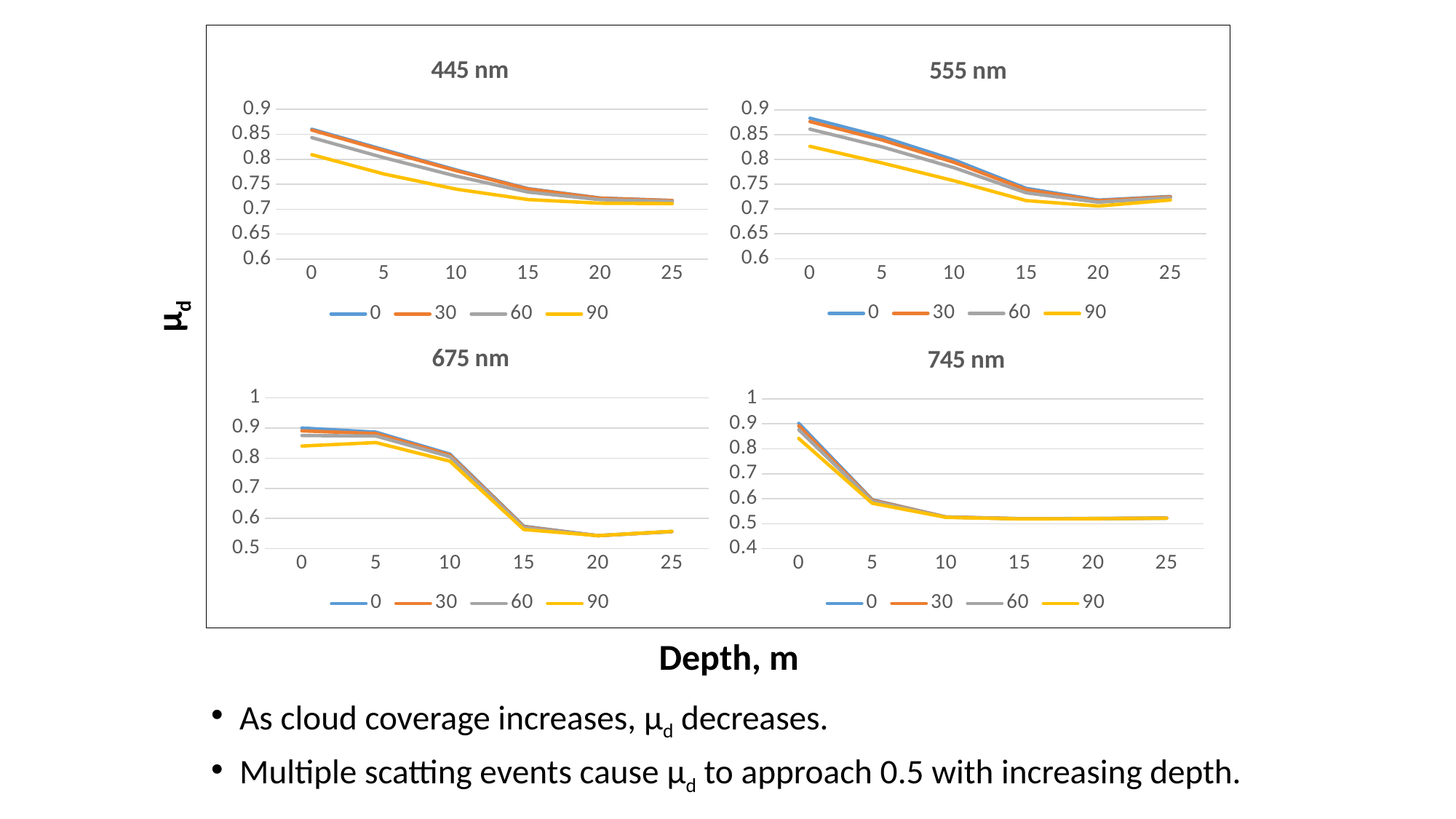
In the 745 nm chart, is the value of the 0 series at depth 5 greater or less than 0.7? less In the 445 nm chart, is the value of the 90 series at depth 0 greater or less than 0.85? less In the 445 nm chart at depth 0, which series has the higher value, 0 or 90? 0 How many depth values are plotted along the x axis of the 675 nm chart? 6 In the 555 nm chart at depth 5, which series has the higher value, 60 or 90? 60 In the 745 nm chart, do the values rise or fall as depth increases from 0 to 10? fall In the 675 nm chart, is the value of the 90 series at depth 0 greater or less than 0.8? greater How many series does the legend of the 555 nm chart list? 4 What is the title of the bottom-left chart? 675 nm What kind of chart is the 445 nm chart? line chart